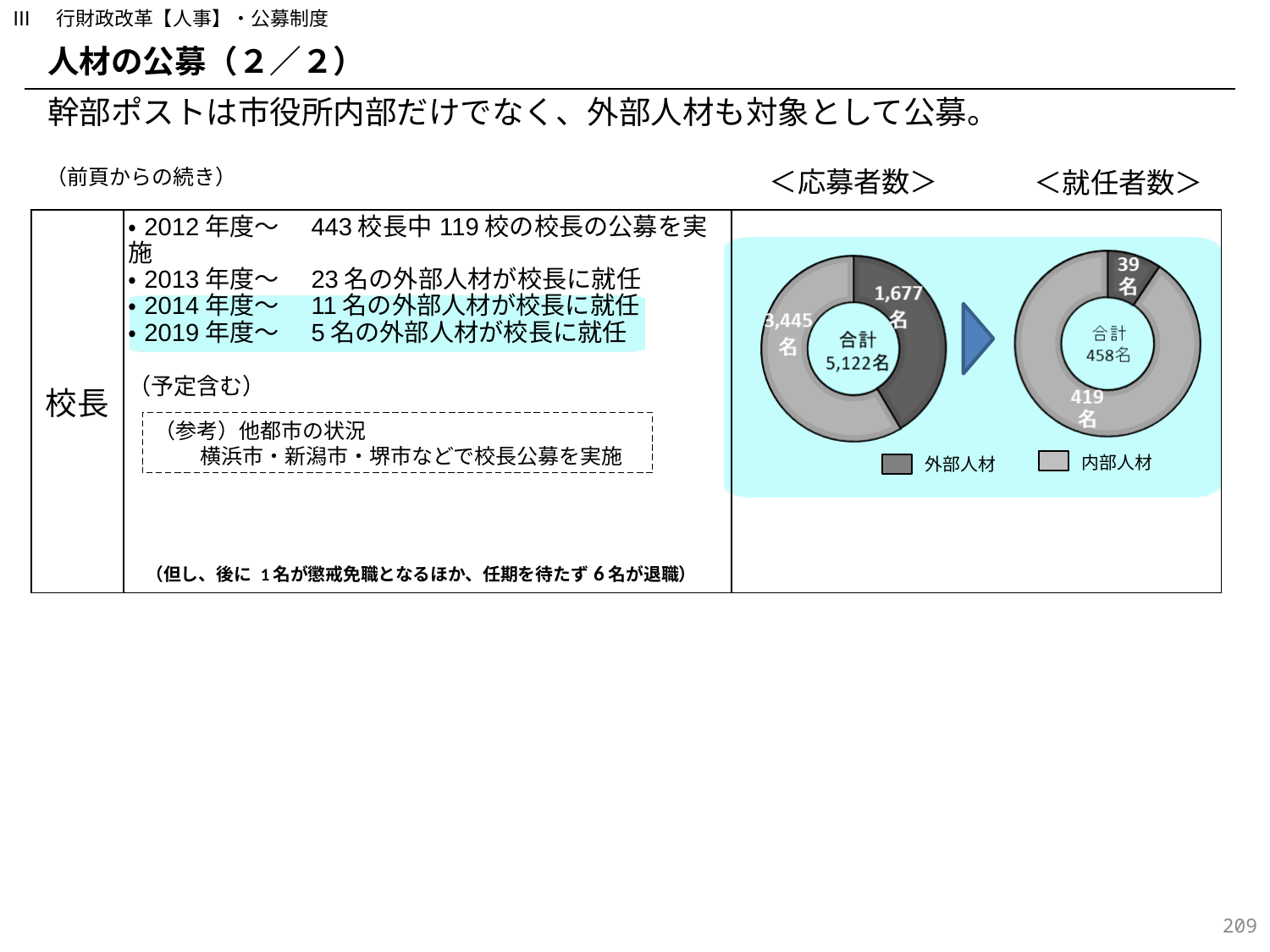
In the ＜応募者数＞ chart, what is the value for 内部人材? 3,445名 In the ＜就任者数＞ chart, what is the total (合計) shown in the centre? 458名 What kind of chart is used for ＜応募者数＞ and ＜就任者数＞? Donut (pie) chart In the ＜就任者数＞ chart, what is the difference between 内部人材 and 外部人材? 380名 In the ＜就任者数＞ chart, what is the value for 外部人材? 39名 In the ＜応募者数＞ chart, what is the difference between 内部人材 and 外部人材? 1,768名 In the ＜就任者数＞ chart, what is the value for 内部人材? 419名 In the ＜応募者数＞ chart, which category is larger, 外部人材 or 内部人材? 内部人材 In the ＜応募者数＞ chart, what is the value for 外部人材? 1,677名 How many series does the legend below the charts list? 2 In the ＜応募者数＞ chart, what is the total (合計) shown in the centre? 5,122名 In the ＜就任者数＞ chart, which category is the smallest? 外部人材